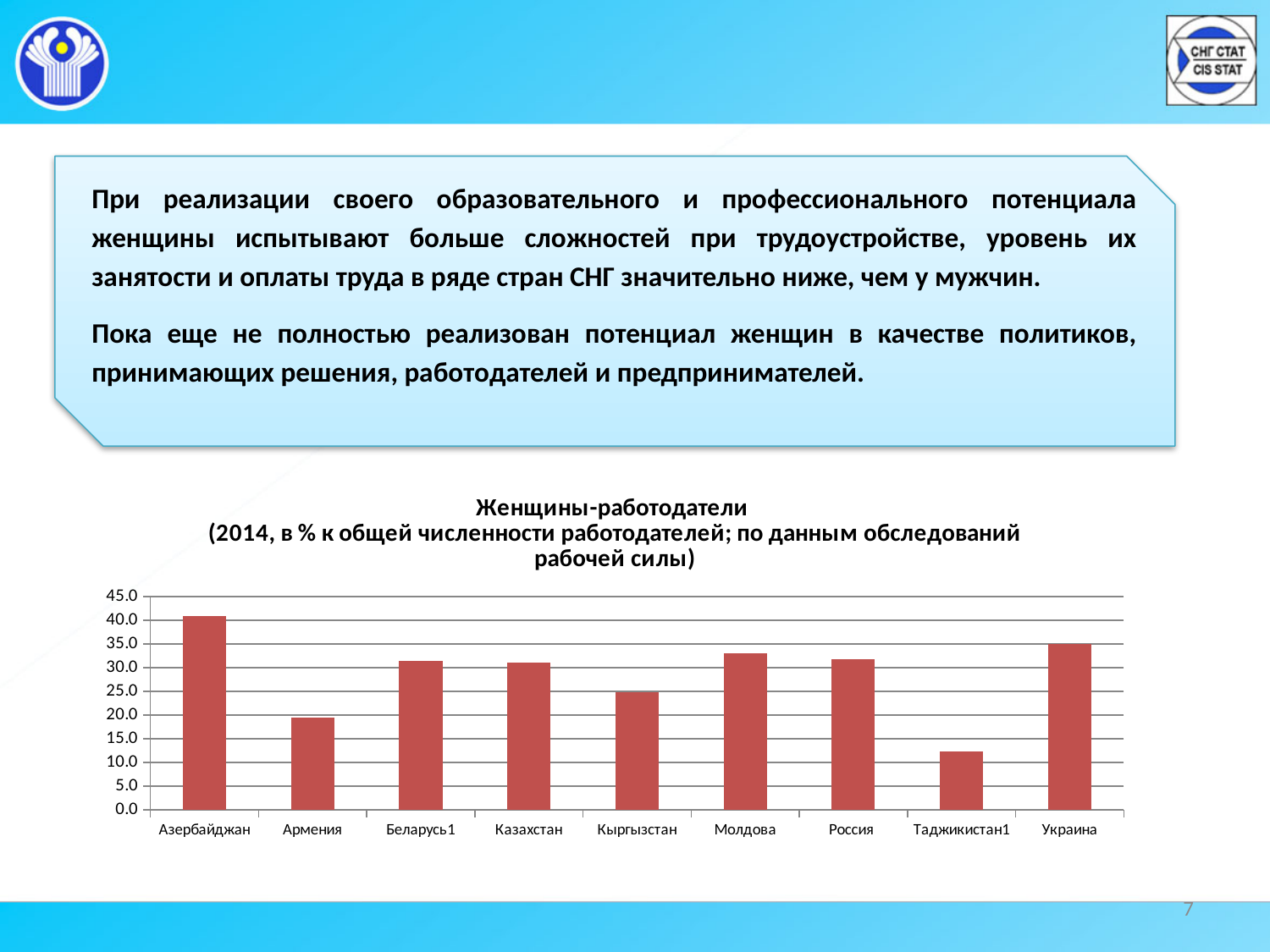
Is the value for Армения greater or less than 20.0? less Is the value for Азербайджан greater or less than 40.0? greater How many countries are shown on the x axis of the chart? 9 Which is larger, the value for Молдова or the value for Кыргызстан? Молдова Which country has the highest share of women employers in the chart? Азербайджан What year does the chart title say the data refer to? 2014 Which is larger, the value for Армения or the value for Таджикистан? Армения Which country has the lowest share of women employers in the chart? Таджикистан Is the value for Кыргызстан greater or less than 30.0? less What kind of chart is shown on the slide? bar chart